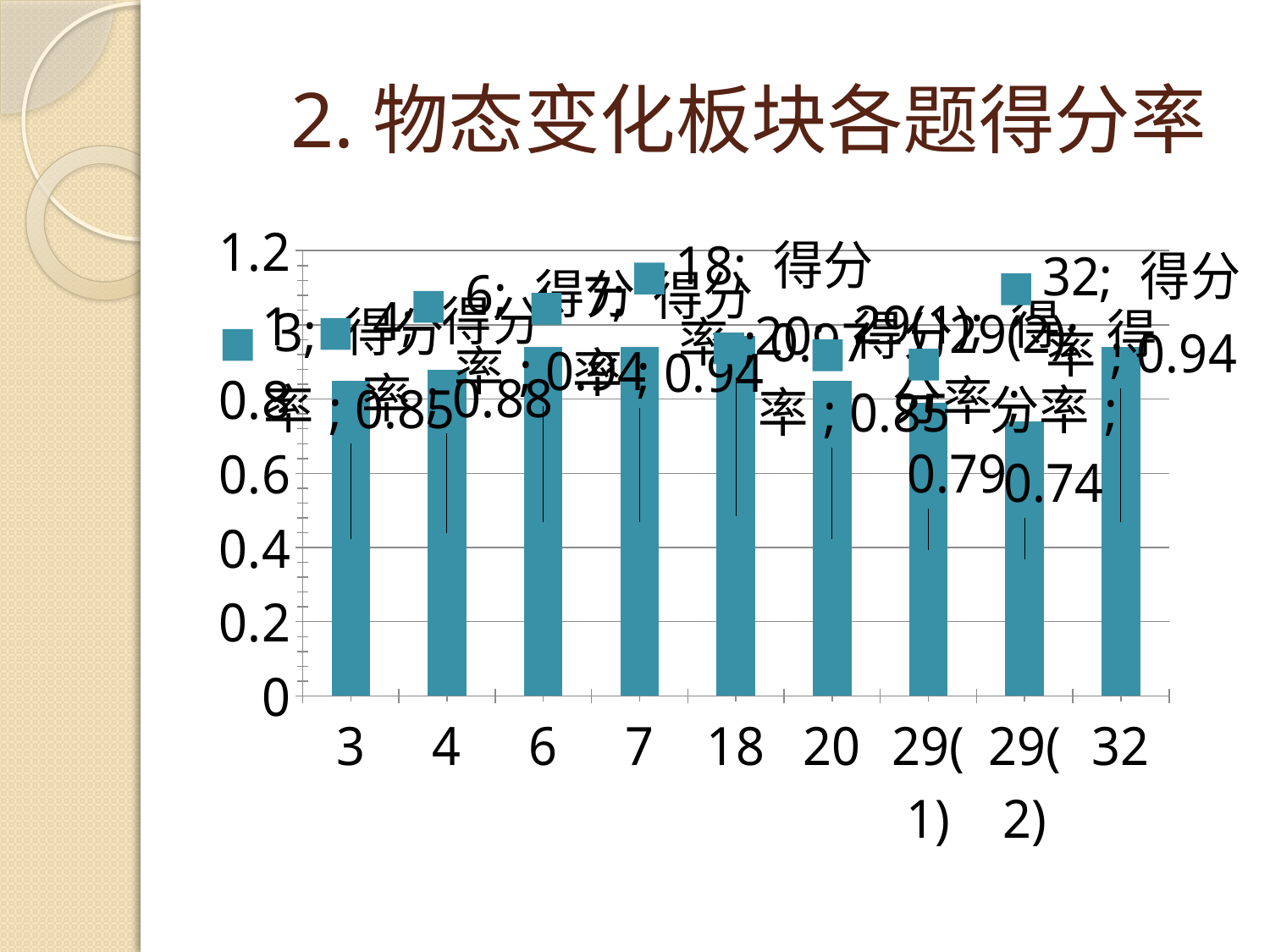
What is the 得分率 value for question 29(2)? 0.74 What is the 得分率 value for question 29(1)? 0.79 Is the value for question 29(2) greater or less than 0.8? less Is the value for question 18 greater or less than 0.8? greater What is the 得分率 value for question 20? 0.85 What is the 得分率 value for question 32? 0.94 How many categories (questions) are plotted on the x axis? 9 What type of chart is shown on the slide? bar chart What is the title of the chart? 2. 物态变化板块各题得分率 Which has a higher 得分率, question 32 or question 29(2)? 32 Which question has the lowest 得分率? 29(2) What is the difference between the 得分率 of question 29(1) and question 29(2)? 0.05